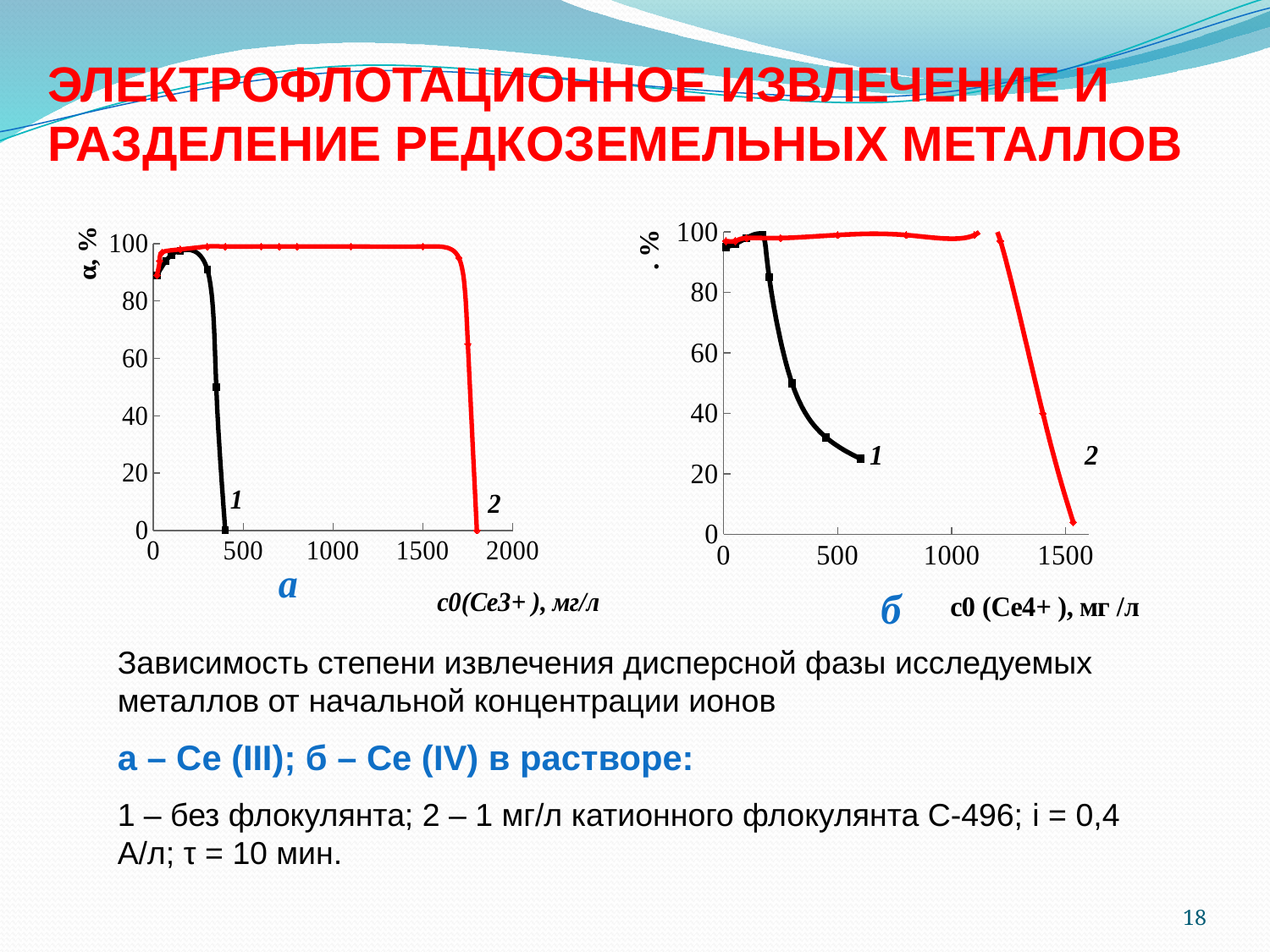
On chart б (right), is the value of curve 2 at c0 = 1000 мг/л greater or less than 80? greater On chart б (right), does curve 1 rise or fall as c0 increases from 200 to 600 мг/л? fall What kind of chart is chart а (left)? line chart On chart а (left), is the value of curve 2 at c0 = 1000 мг/л greater or less than 80? greater On chart а (left), what is the label of the x axis? c0(Ce3+ ), мг/л On chart б (right), what is the label of the x axis? c0 (Ce4+ ), мг /л On chart а (left), what is the highest tick value shown on the x axis? 2000 On chart б (right), is the value of curve 2 at c0 = 1500 мг/л greater or less than 40? less How many curves are plotted on chart б (right)? 2 On chart а (left), does curve 1 rise or fall as c0 increases beyond about 200 мг/л? fall On chart б (right), at c0 = 500 мг/л, which curve has the larger value, curve 1 or curve 2? curve 2